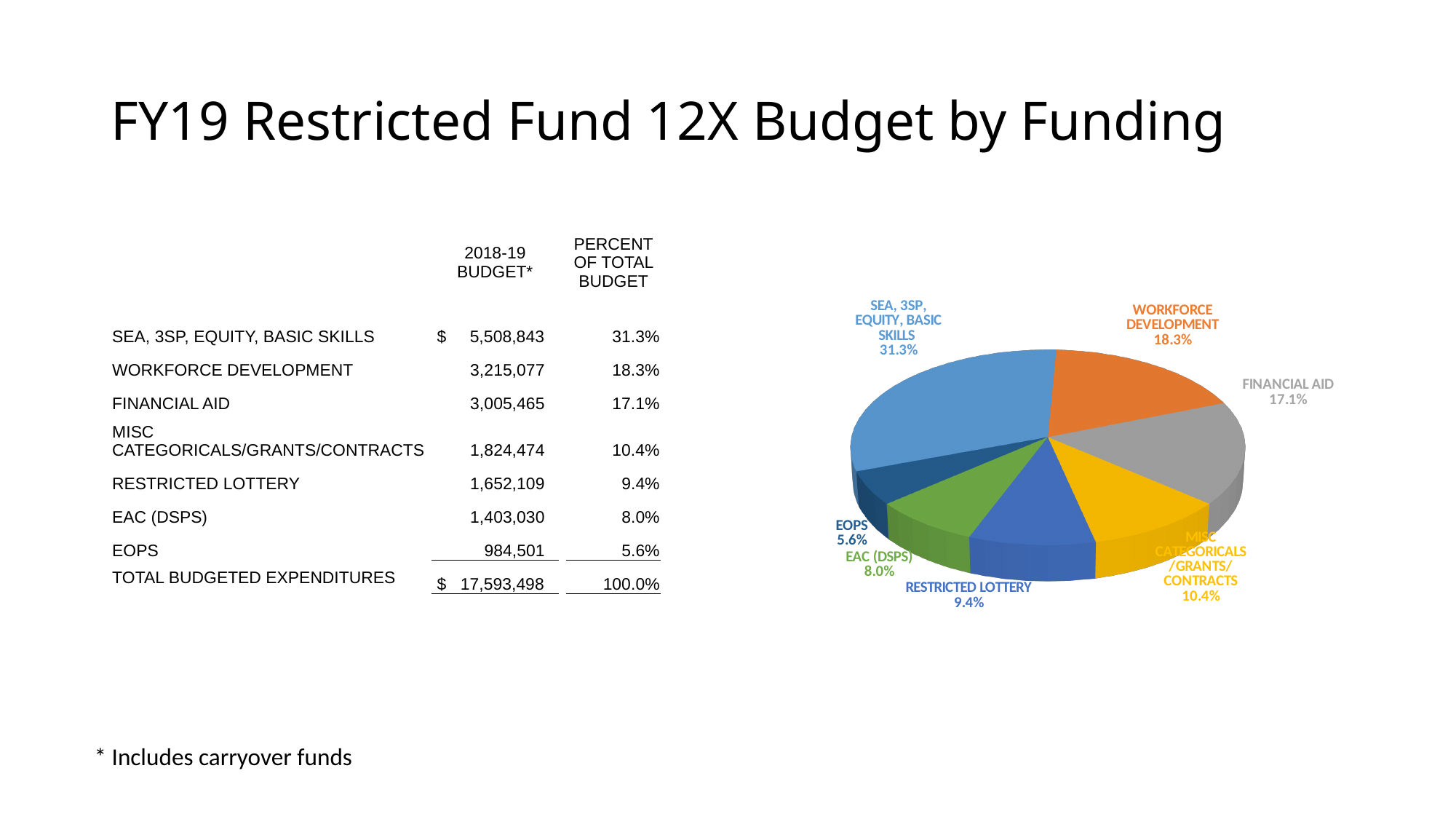
What share of the pie does WORKFORCE DEVELOPMENT represent? 18.3% Which slice is larger, EAC (DSPS) or RESTRICTED LOTTERY? RESTRICTED LOTTERY What share of the pie does EOPS represent? 5.6% Which category has the smallest slice of the pie? EOPS What kind of chart is shown on the slide? Pie chart What share of the pie does FINANCIAL AID represent? 17.1% What colour is the FINANCIAL AID slice of the pie? Gray Which category has the largest slice of the pie? SEA, 3SP, EQUITY, BASIC SKILLS How many slices does the pie chart have? 7 What is the difference in percentage points between the MISC CATEGORICALS/GRANTS/CONTRACTS slice and the EOPS slice? 4.8% What is the difference in percentage points between the SEA, 3SP, EQUITY, BASIC SKILLS slice and the WORKFORCE DEVELOPMENT slice? 13.0%